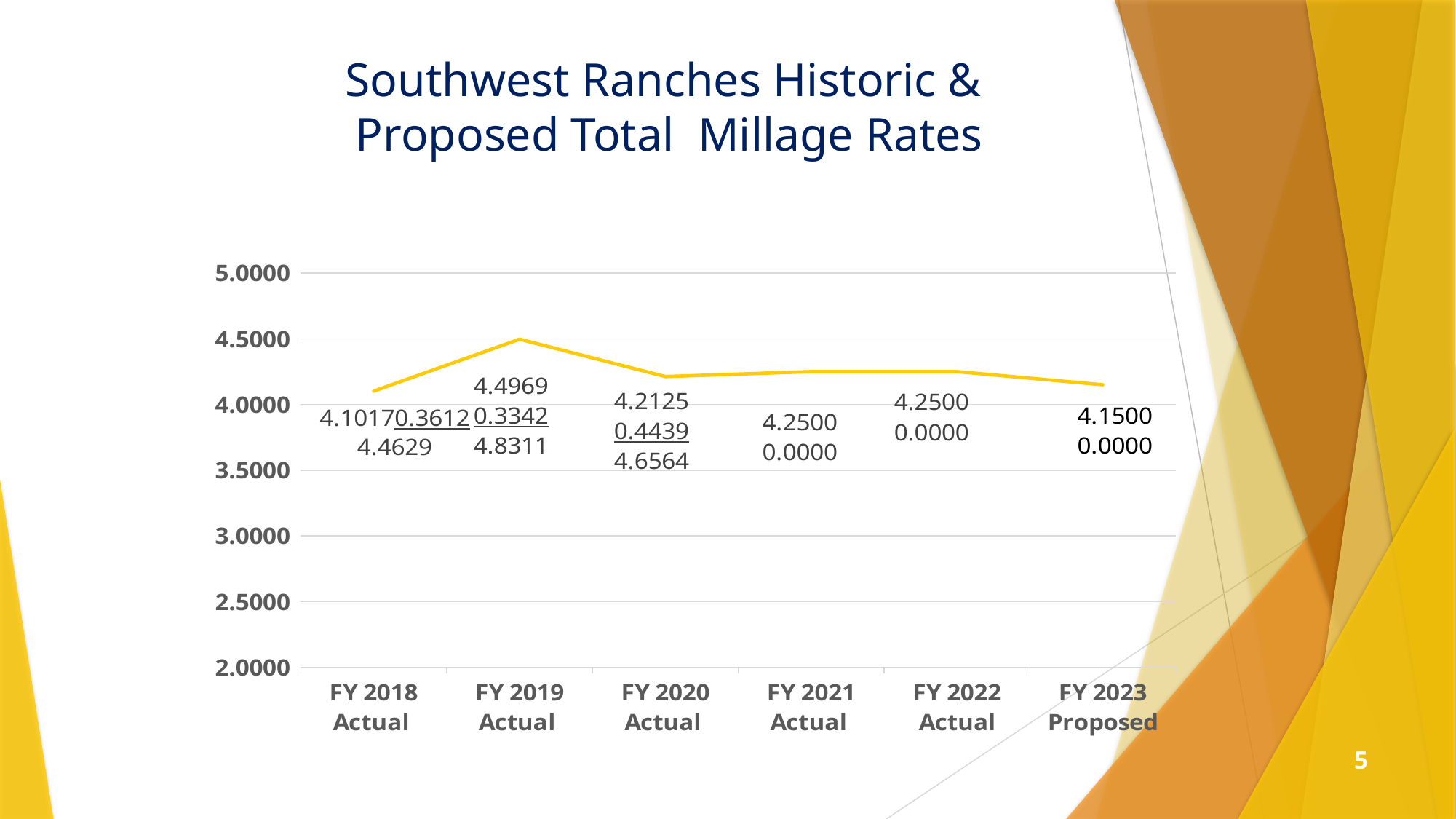
Which has the higher plotted point on the line, FY 2019 Actual or FY 2020 Actual? FY 2019 Actual What is the bottom (total) value printed in the label for FY 2019 Actual? 4.8311 What is the difference between the bottom (total) values printed for FY 2019 Actual (4.8311) and FY 2018 Actual (4.4629)? 0.3682 What is the top value printed in the label for FY 2020 Actual? 4.2125 What is the title of the chart on the slide? Southwest Ranches Historic & Proposed Total Millage Rates How many fiscal years are shown on the x axis of the chart? 6 In which fiscal year does the plotted line reach its highest point? FY 2019 Actual Does the plotted line rise or fall from FY 2019 Actual to FY 2020 Actual? fall What is the second value printed in the label for FY 2021 Actual? 0.0000 What is the underlined value printed in the label for FY 2020 Actual? 0.4439 What type of chart is shown on the slide? line chart Is the plotted value for FY 2018 Actual greater or less than 4.5000? less